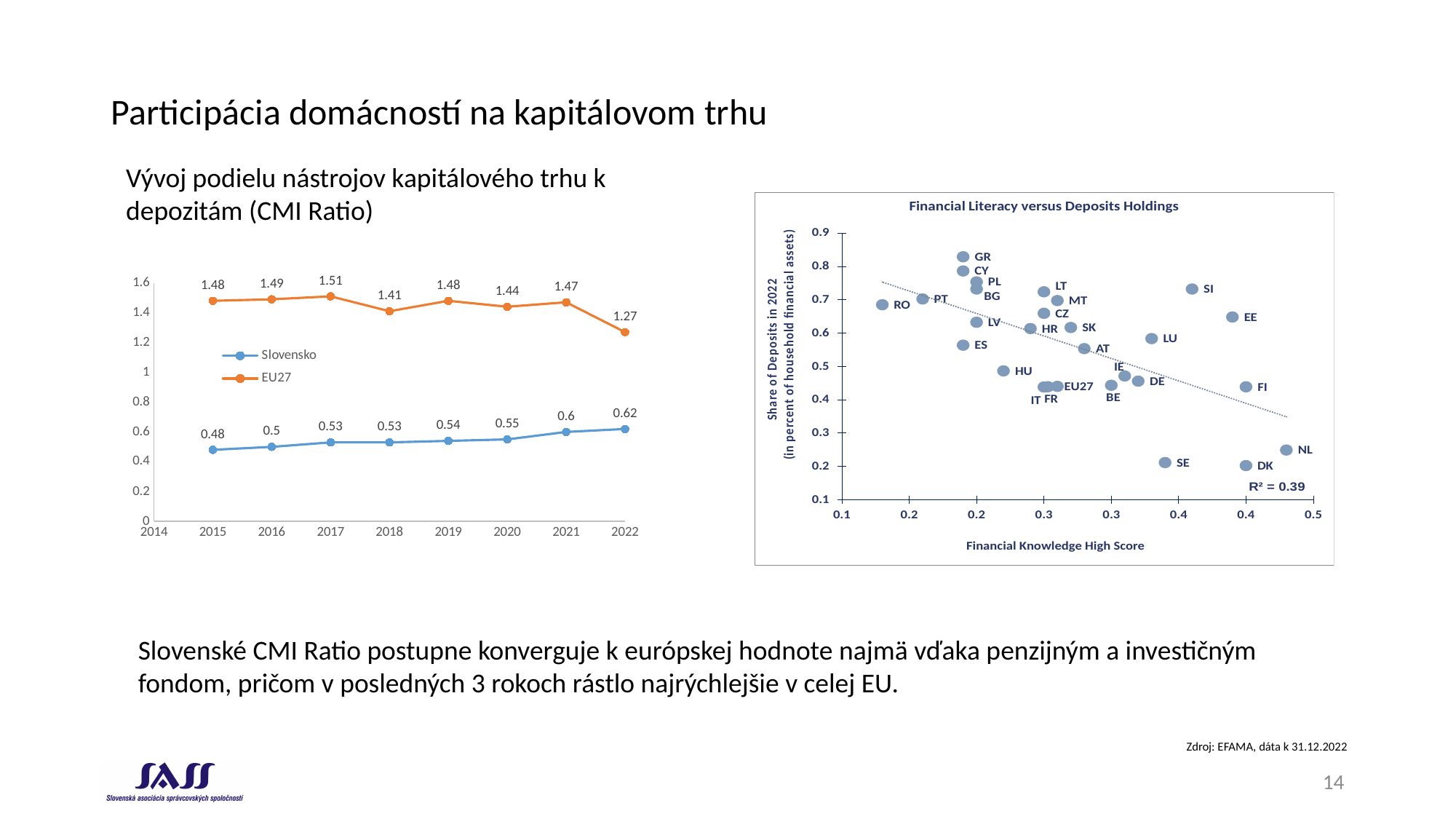
How many years have data points plotted in the CMI Ratio line chart on the left? 8 In the CMI Ratio line chart on the left, in which year is the EU27 value highest? 2017 In the CMI Ratio line chart on the left, is the Slovensko value higher in 2021 or in 2020? 2021 In the CMI Ratio line chart on the left, in which year is the EU27 value lowest? 2022 What kind of chart is the 'Financial Literacy versus Deposits Holdings' chart on the right? scatter chart In the CMI Ratio line chart on the left, what is the difference between the EU27 and Slovensko values in 2022? 0.65 In the CMI Ratio line chart on the left, what is the value for EU27 in 2018? 1.41 In the CMI Ratio line chart on the left, what is the value for Slovensko in 2022? 0.62 In the 'Financial Literacy versus Deposits Holdings' chart, is the share of deposits for NL greater or less than 0.3? less In the CMI Ratio line chart on the left, does the Slovensko series rise or fall from 2015 to 2022? rises What kind of chart is the chart on the left of the slide? line chart How many series does the legend of the CMI Ratio line chart on the left list? 2